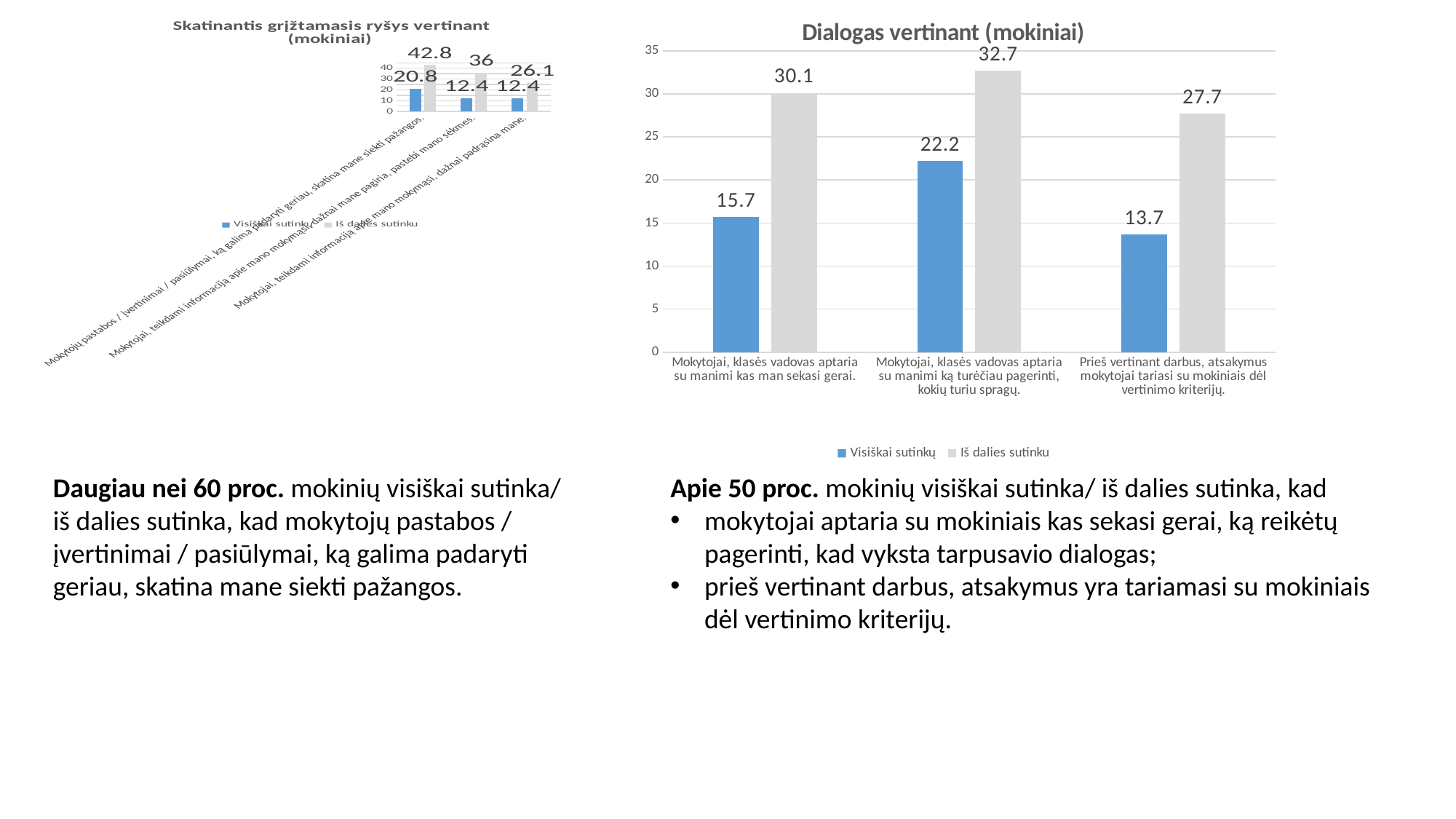
In the chart titled "Dialogas vertinant (mokiniai)", how many categories are shown on the x axis? 3 In the chart titled "Skatinantis grįžtamasis ryšys vertinant (mokiniai)", what is the highest value shown by a data label? 42.8 In the chart titled "Dialogas vertinant (mokiniai)", which category has the highest "Visiškai sutinkų" value? Mokytojai, klasės vadovas aptaria su manimi ką turėčiau pagerinti, kokių turiu spragų. What kind of chart is the chart titled "Dialogas vertinant (mokiniai)"? bar chart In the chart titled "Dialogas vertinant (mokiniai)", what is the value of "Iš dalies sutinku" for "Prieš vertinant darbus, atsakymus mokytojai tariasi su mokiniais dėl vertinimo kriterijų."? 27.7 In the chart titled "Skatinantis grįžtamasis ryšys vertinant (mokiniai)", which is larger: the "Iš dalies sutinku" value for the first category (42.8) or for the third category (26.1)? the first category (42.8) In the chart titled "Dialogas vertinant (mokiniai)", how many series does the legend list? 2 In the chart titled "Dialogas vertinant (mokiniai)", what is the difference between the "Iš dalies sutinku" and "Visiškai sutinkų" values for "Mokytojai, klasės vadovas aptaria su manimi ką turėčiau pagerinti, kokių turiu spragų."? 10.5 In the chart titled "Dialogas vertinant (mokiniai)", is the "Visiškai sutinkų" value for "Prieš vertinant darbus, atsakymus mokytojai tariasi su mokiniais dėl vertinimo kriterijų." greater or less than 15? less In the chart titled "Dialogas vertinant (mokiniai)", which category has the lowest "Iš dalies sutinku" value? Prieš vertinant darbus, atsakymus mokytojai tariasi su mokiniais dėl vertinimo kriterijų. In the chart titled "Dialogas vertinant (mokiniai)", which colour represents the "Iš dalies sutinku" series? grey In the chart titled "Dialogas vertinant (mokiniai)", what is the value of "Visiškai sutinkų" for "Mokytojai, klasės vadovas aptaria su manimi kas man sekasi gerai."? 15.7